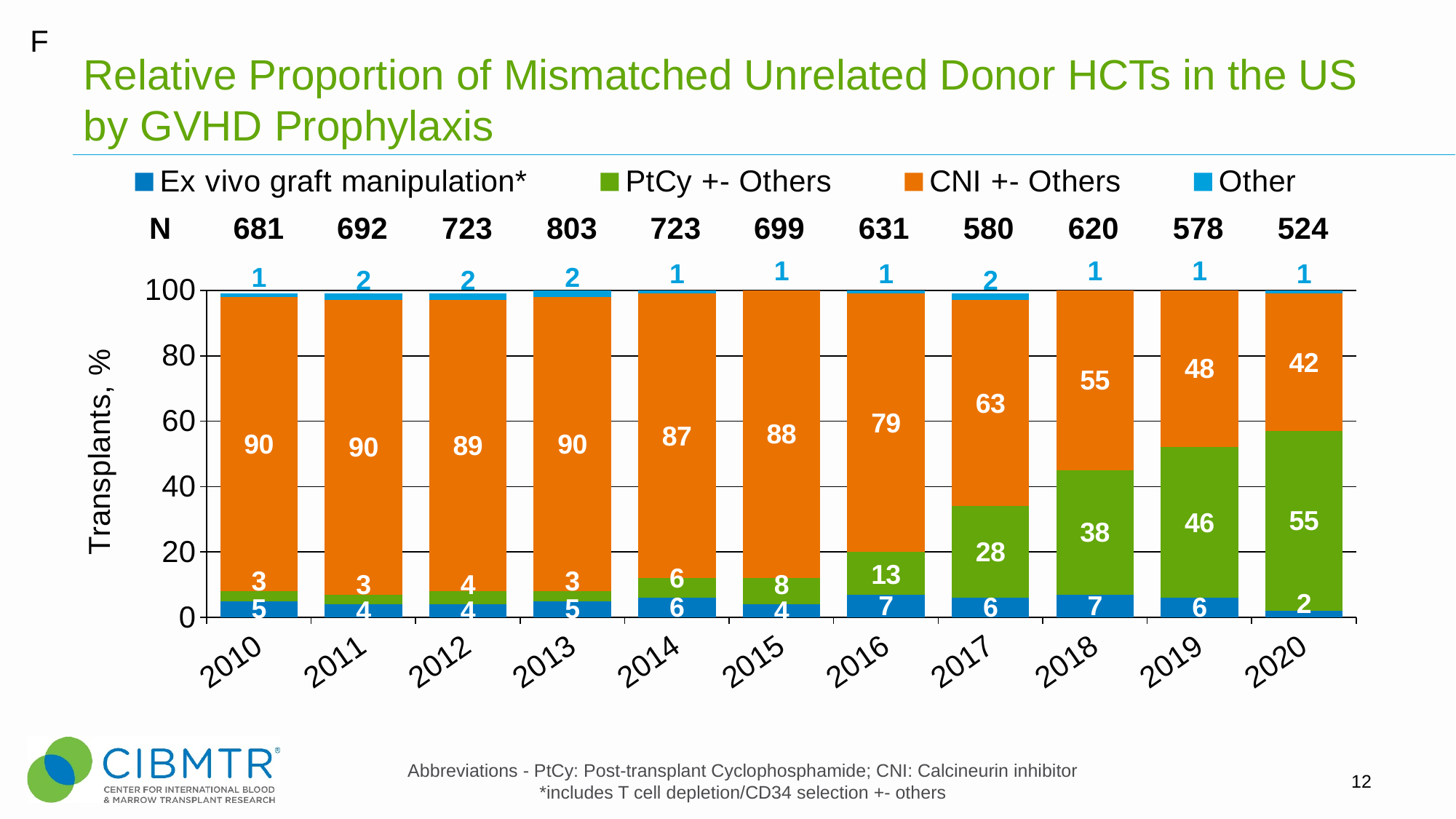
How many years are shown on the x axis? 11 What is the label of the y axis? Transplants, % What is the difference between the CNI +- Others value in 2010 and in 2020? 48 Does the PtCy +- Others share rise or fall from 2015 to 2020? Rise In which year is the CNI +- Others share the lowest? 2020 What kind of chart is shown on the slide? Stacked bar chart In 2019, which is larger: the PtCy +- Others share or the CNI +- Others share? CNI +- Others What is the value for CNI +- Others in 2016? 79 What is the N (number of transplants) shown for 2013? 803 How many series does the legend list? 4 What percentage of transplants in 2020 used PtCy +- Others? 55 In which year is the PtCy +- Others share the highest? 2020